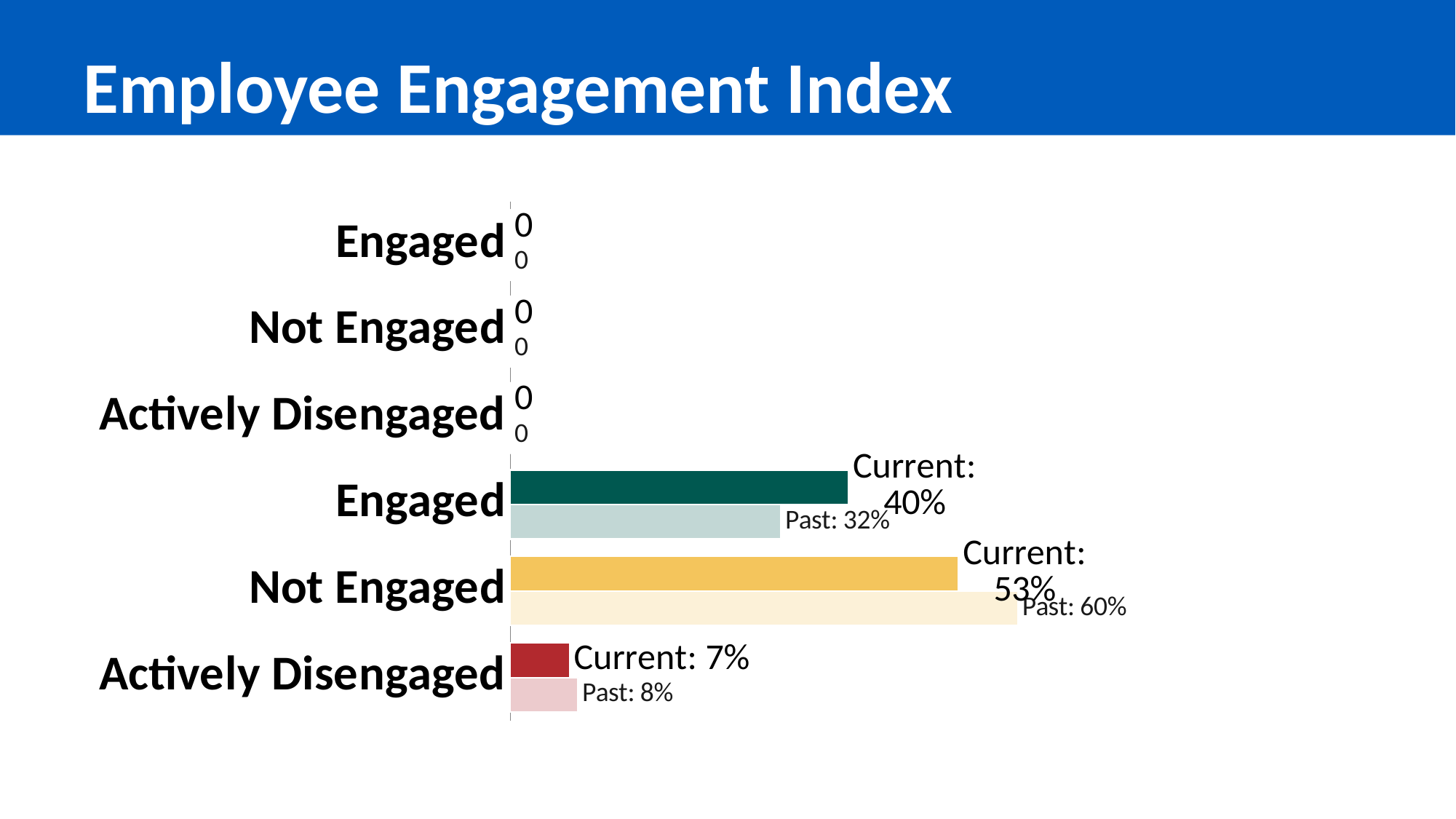
What is the Current value for Actively Disengaged? 7% What is the difference between the Current and Past values for Engaged? 8% What is the Current value for Engaged? 40% Which category has the highest Current value? Not Engaged What is the Past value for Actively Disengaged? 8% What is the Past value for Engaged? 32% What is the Past value for Not Engaged? 60% What kind of chart is shown on the slide? bar chart What is the title of the slide? Employee Engagement Index Is the Past value for Not Engaged larger or smaller than its Current value? larger What is the Current value for Not Engaged? 53% Which category has the lowest Past value? Actively Disengaged